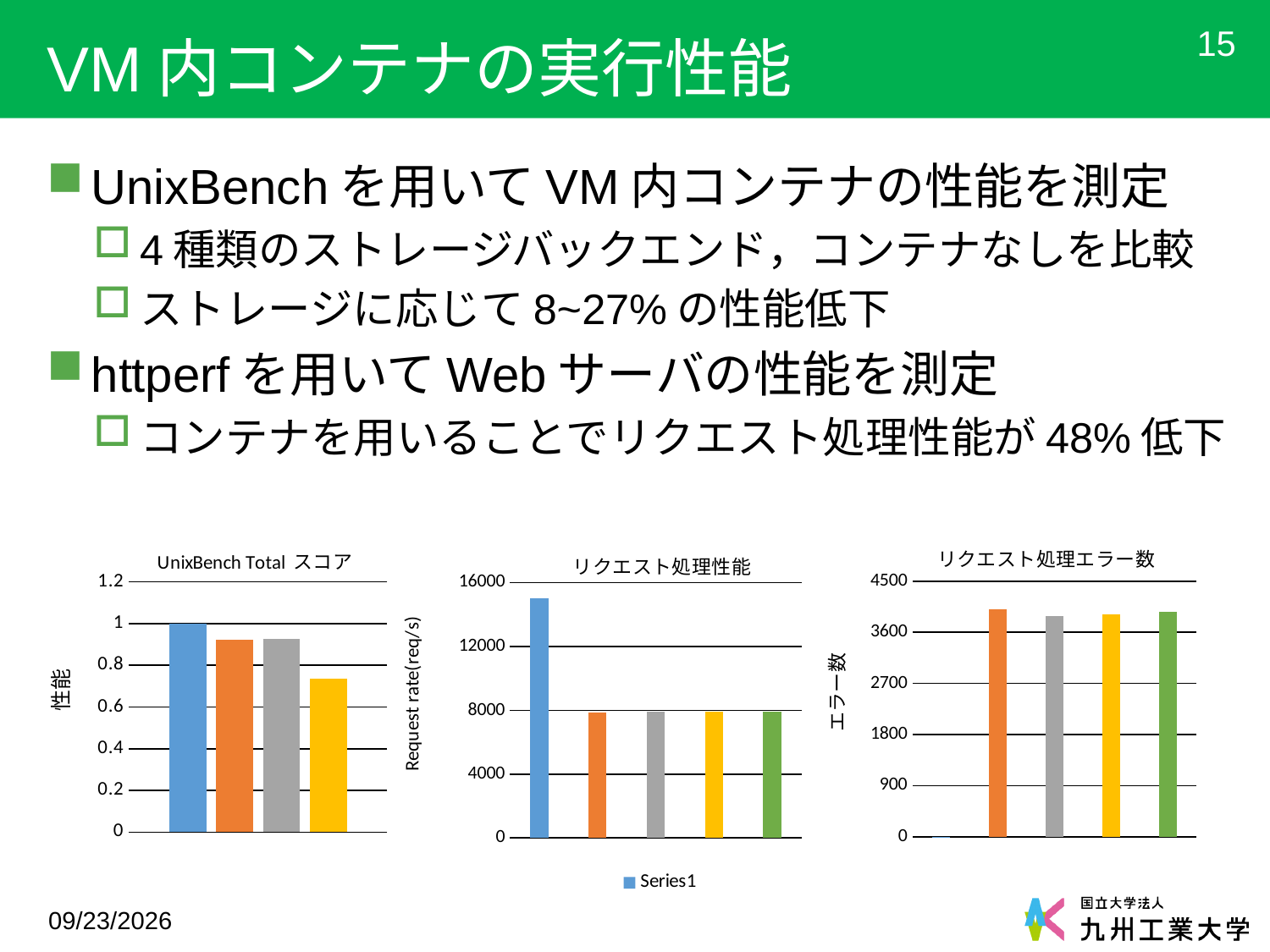
In the 'リクエスト処理性能' chart, is the value of the first (blue) bar greater or less than 12000? greater How many bars are plotted in the 'UnixBench Total スコア' chart? 4 In the 'リクエスト処理性能' chart, is the value of the second (orange) bar greater or less than 12000? less What is the y-axis label of the 'リクエスト処理性能' chart? Request rate(req/s) What kind of chart is the 'UnixBench Total スコア' chart? bar chart How many bars are plotted in the 'リクエスト処理性能' chart? 5 What is the y-axis label of the 'UnixBench Total スコア' chart? 性能 In the 'UnixBench Total スコア' chart, which bar is the lowest? the fourth (yellow) bar In the 'UnixBench Total スコア' chart, is the value of the fourth (yellow) bar greater or less than 0.8? less In the 'UnixBench Total スコア' chart, which bar is the highest? the first (blue) bar In the 'リクエスト処理性能' chart, which bar is the highest? the first (blue) bar